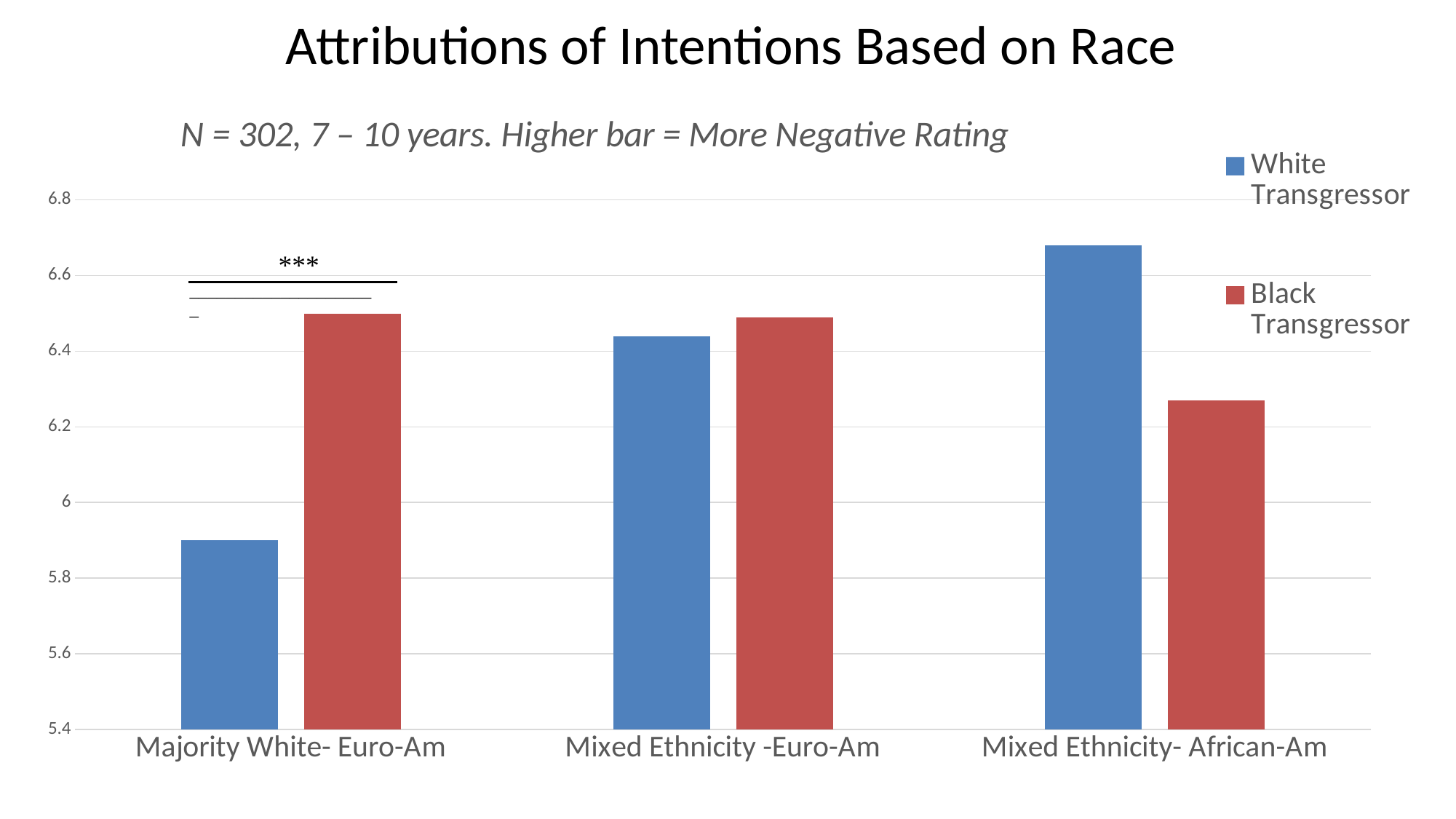
For Majority White- Euro-Am, which is larger: the White Transgressor value or the Black Transgressor value? Black Transgressor What kind of chart is shown on the slide? Bar chart Which category has the lowest Black Transgressor value? Mixed Ethnicity- African-Am What colour represents the Black Transgressor series? Red Is the Black Transgressor value for Mixed Ethnicity- African-Am greater or less than 6.4? less How many series does the legend list? 2 How many categories are shown on the x axis? 3 Is the White Transgressor value for Mixed Ethnicity- African-Am greater or less than 6.6? greater Which category has the highest White Transgressor value? Mixed Ethnicity- African-Am Is the White Transgressor value for Majority White- Euro-Am greater or less than 6? less For Mixed Ethnicity- African-Am, which is larger: the White Transgressor value or the Black Transgressor value? White Transgressor